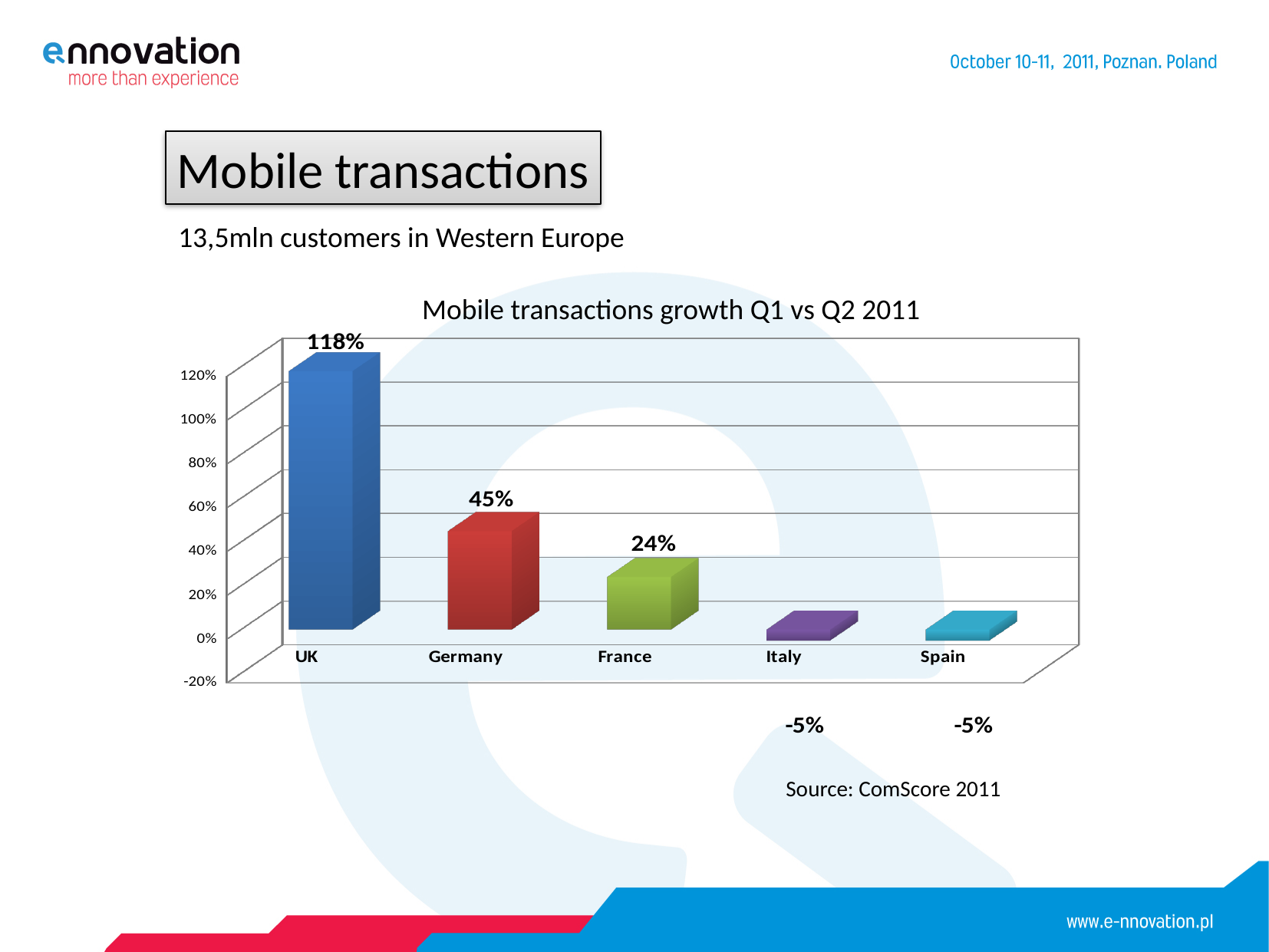
What is the value for Spain in the chart? -5% Is the value for UK greater or less than 100%? greater How many countries are shown in the chart? 5 Which country has the highest mobile transactions growth in the chart? UK Which has the larger value, Germany or France? Germany What is the value for UK in the Mobile transactions growth Q1 vs Q2 2011 chart? 118% What is the difference between the values for Germany and France? 21% What is the value for France in the chart? 24% What kind of chart is shown on the slide? bar chart What is the value for Germany in the chart? 45% What is the value for Italy in the chart? -5% What is the difference between the values for UK and Germany? 73%